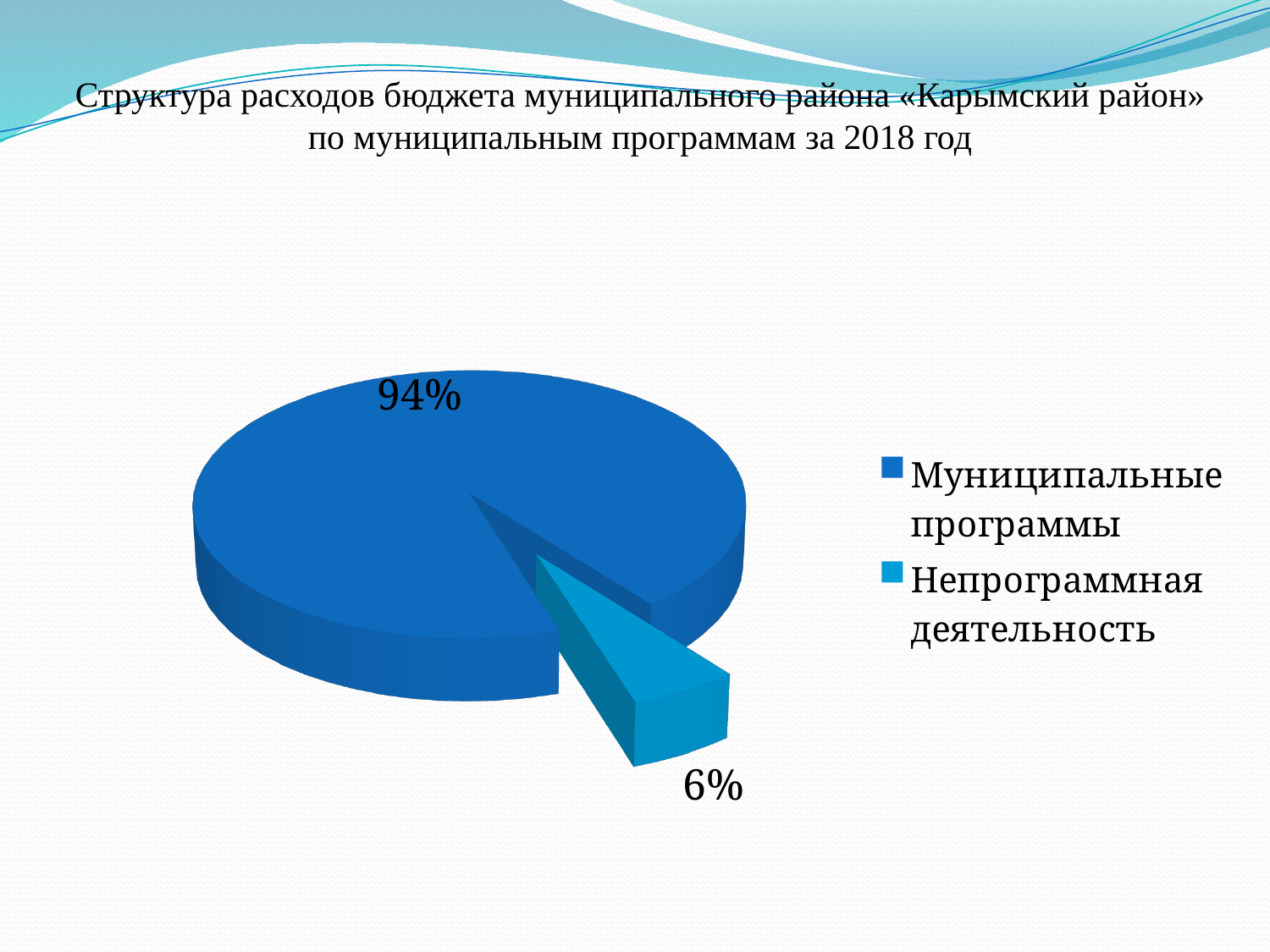
How many entries does the legend list? 2 How many slices does the pie chart have? 2 What share of the pie does Муниципальные программы account for? 94% Which slice is pulled out (exploded) from the pie? Непрограммная деятельность What year does the slide title say the budget expenditure structure refers to? 2018 What share of the pie does Непрограммная деятельность account for? 6% What is the difference in percentage points between the Муниципальные программы slice and the Непрограммная деятельность slice? 88 Which category has the largest slice of the pie? Муниципальные программы Which is larger: the slice for Муниципальные программы or the slice for Непрограммная деятельность? Муниципальные программы What kind of chart is shown on the slide? Pie chart Which category has the smallest slice of the pie? Непрограммная деятельность